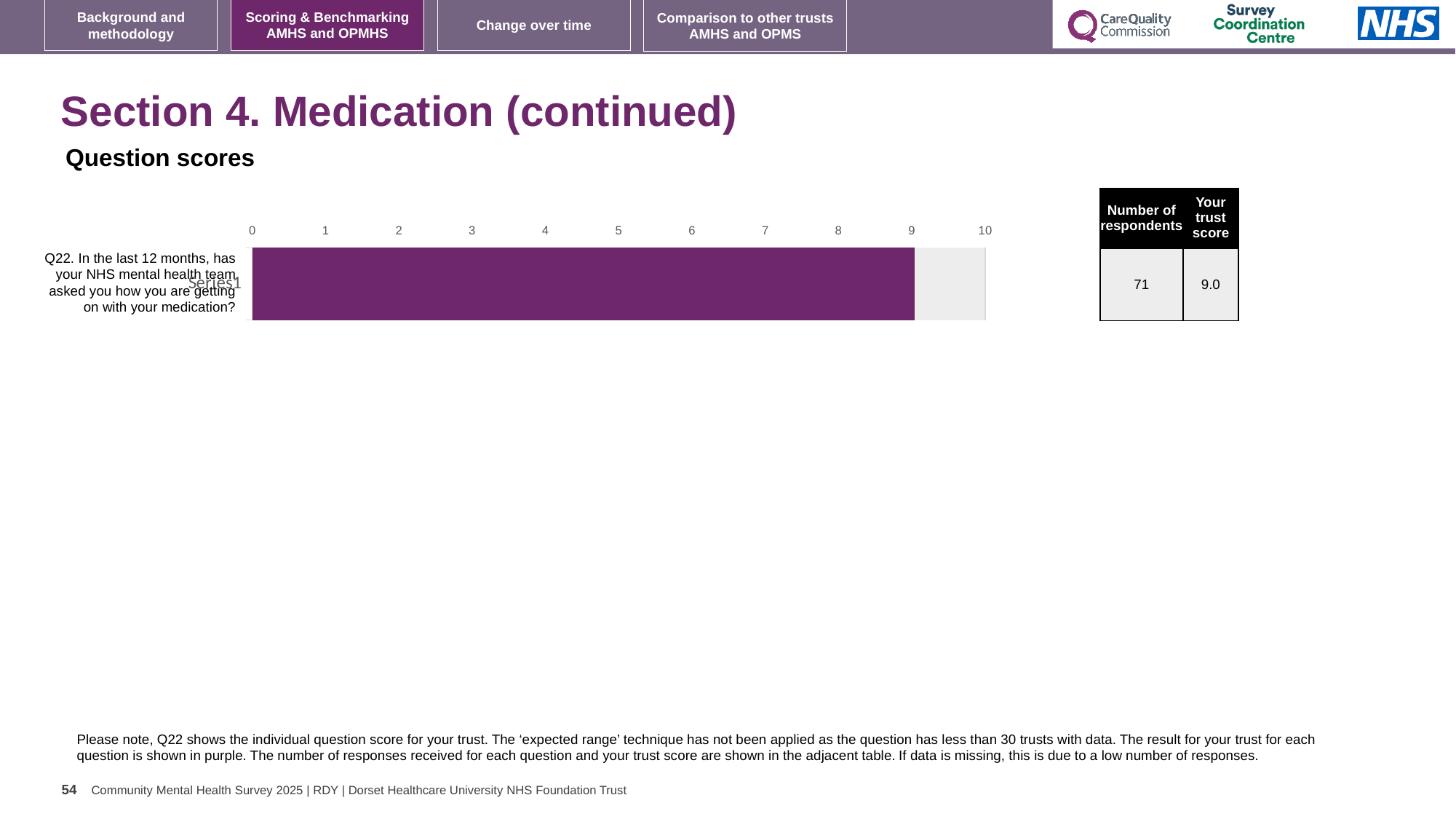
How many respondents are listed for Q22 in the table next to the chart? 71 How many questions (bars) are plotted in the chart? 1 Is the value for Q22 greater or less than 10? less Is the value for Q22 greater or less than 5? greater What kind of chart is shown on the slide? bar chart What is the trust score for Q22 shown in the chart? 9.0 What is the maximum value shown on the chart's horizontal axis? 10 Is the value for Q22 greater or less than 8? greater What colour is the bar for Q22 in the chart? purple